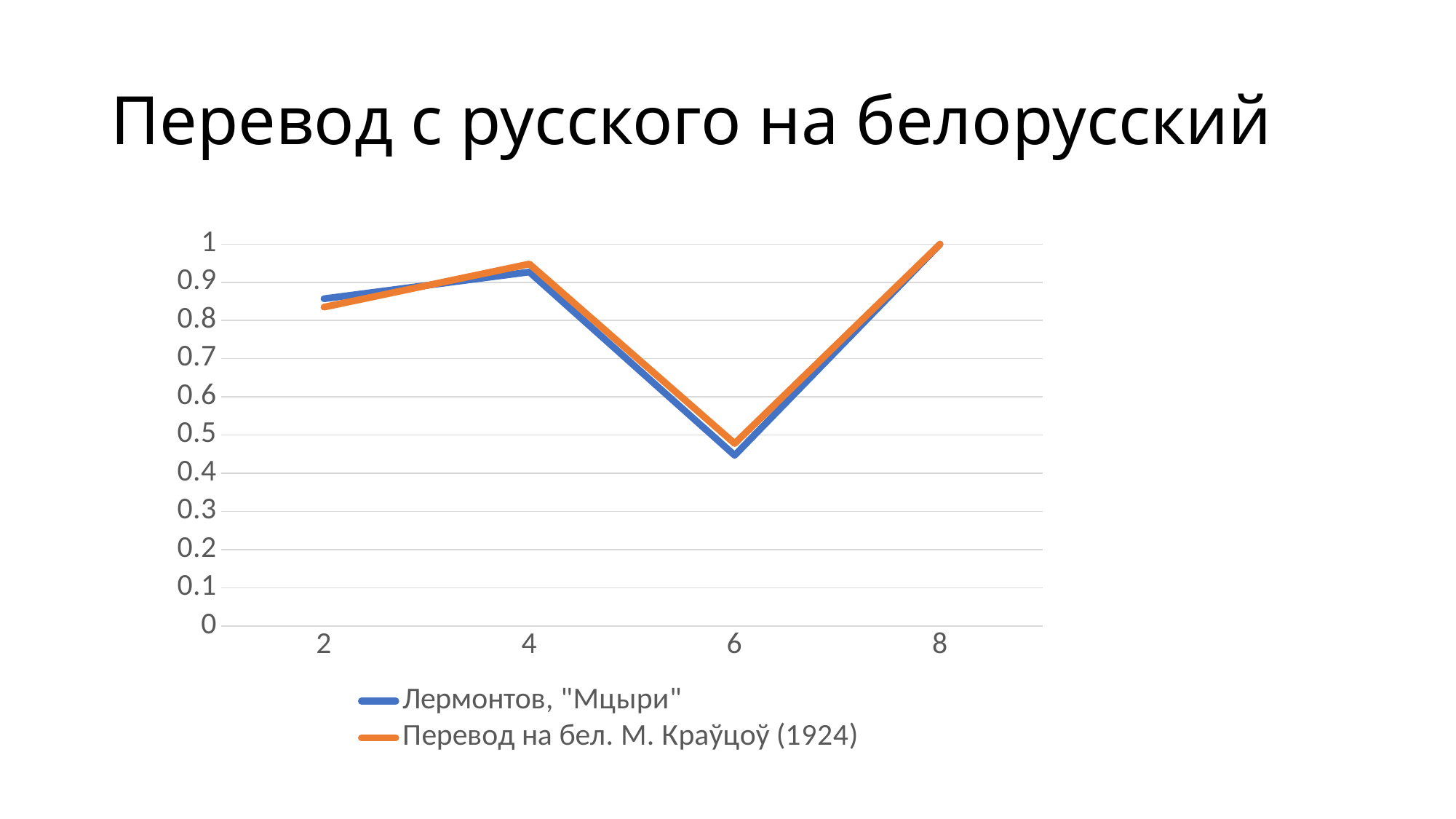
Is the value for Перевод на бел. М. Краўцоў (1924) at x = 6 greater or less than 0.6? less Is the value for Лермонтов, "Мцыри" at x = 6 greater or less than 0.5? less Which series is drawn in orange? Перевод на бел. М. Краўцоў (1924) At which x value does the series Перевод на бел. М. Краўцоў (1924) reach its lowest value? 6 What is the title of the slide? Перевод с русского на белорусский What is the value of the series Лермонтов, "Мцыри" at x = 8? 1 How many points are plotted along the x axis for each series? 4 At which x value does the series Лермонтов, "Мцыри" reach its highest value? 8 Do the values of the series Лермонтов, "Мцыри" rise or fall between x = 4 and x = 6? fall How many series does the legend list? 2 Is the value for Перевод на бел. М. Краўцоў (1924) at x = 4 greater or less than 0.9? greater What kind of chart is shown on the slide? line chart